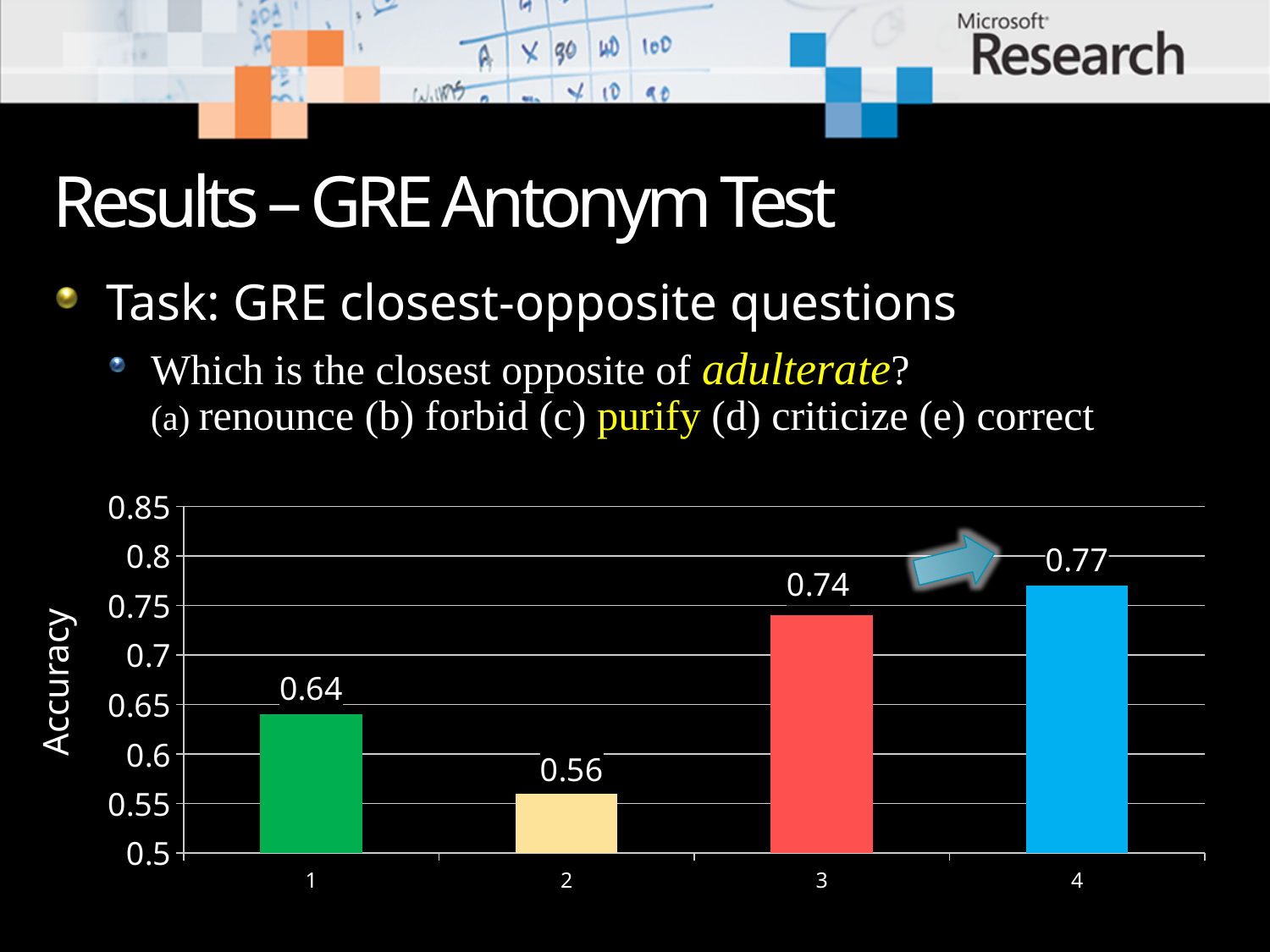
What is the accuracy value for category 1? 0.64 What is the label of the vertical axis of the chart? Accuracy What is the accuracy value for category 2? 0.56 Which category has the highest accuracy? 4 Which has a higher accuracy, category 1 or category 3? 3 How many bars are shown in the chart? 4 Which category has the lowest accuracy? 2 What type of chart is shown on the slide? bar chart What is the accuracy value for category 3? 0.74 What is the difference in accuracy between category 3 and category 2? 0.18 What is the difference in accuracy between category 4 and category 1? 0.13 What is the accuracy value for category 4? 0.77